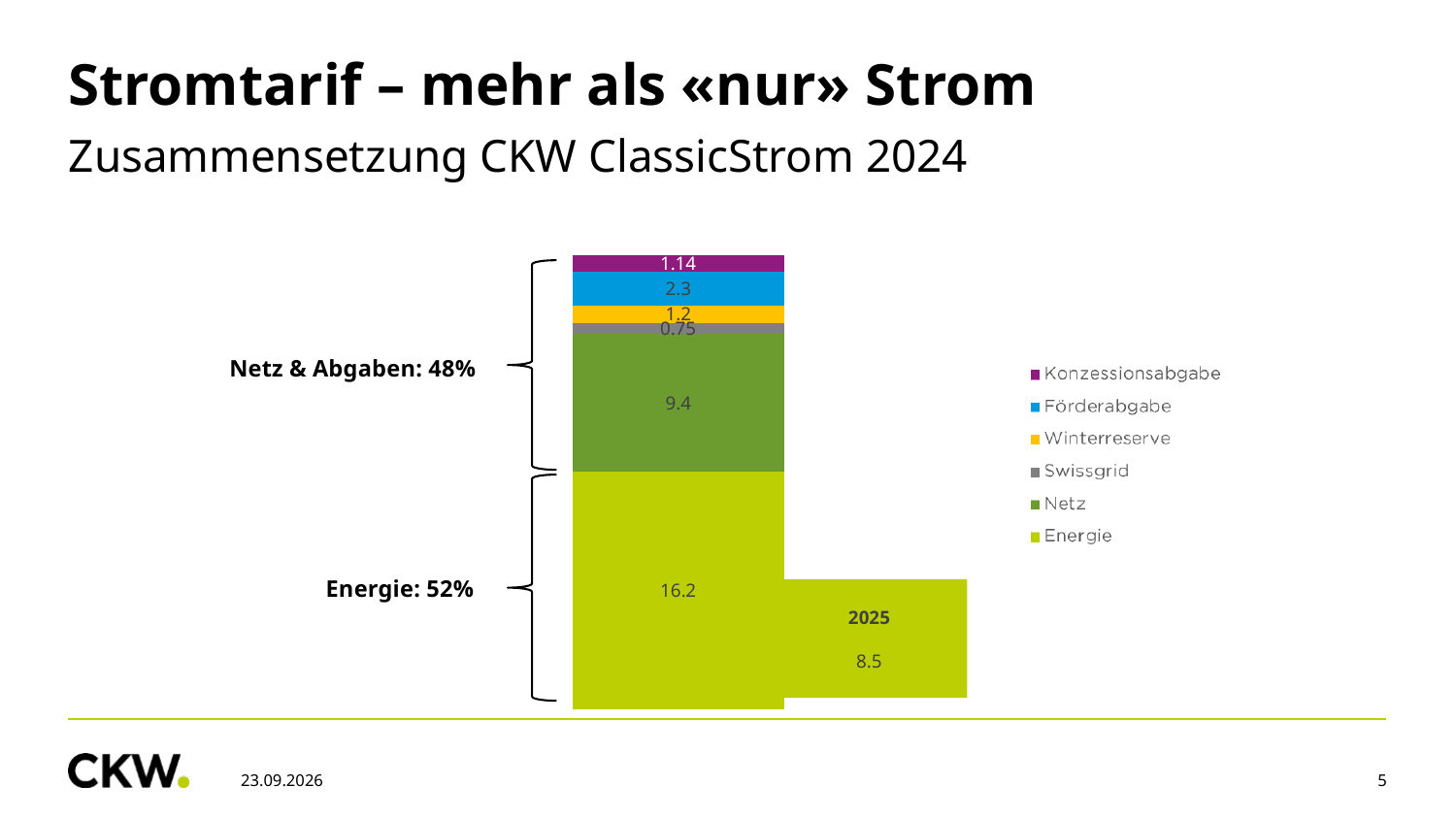
What type of chart is shown on the slide? Stacked bar chart How many entries does the legend list? 6 What is the value of the Energie segment in the stacked bar? 16.2 What is the value of the Konzessionsabgabe segment? 1.14 What is the value of the Netz segment in the stacked bar? 9.4 What is the difference between the Energie value of 16.2 and the 2025 value of 8.5? 7.7 What is the difference between the Energie segment (16.2) and the Netz segment (9.4)? 6.8 Which is larger, the Förderabgabe segment or the Winterreserve segment? Förderabgabe Which segment of the stacked bar has the largest value? Energie What is the value of the Swissgrid segment? 0.75 Which segment of the stacked bar has the smallest value? Swissgrid What value is shown for the 2025 bar? 8.5